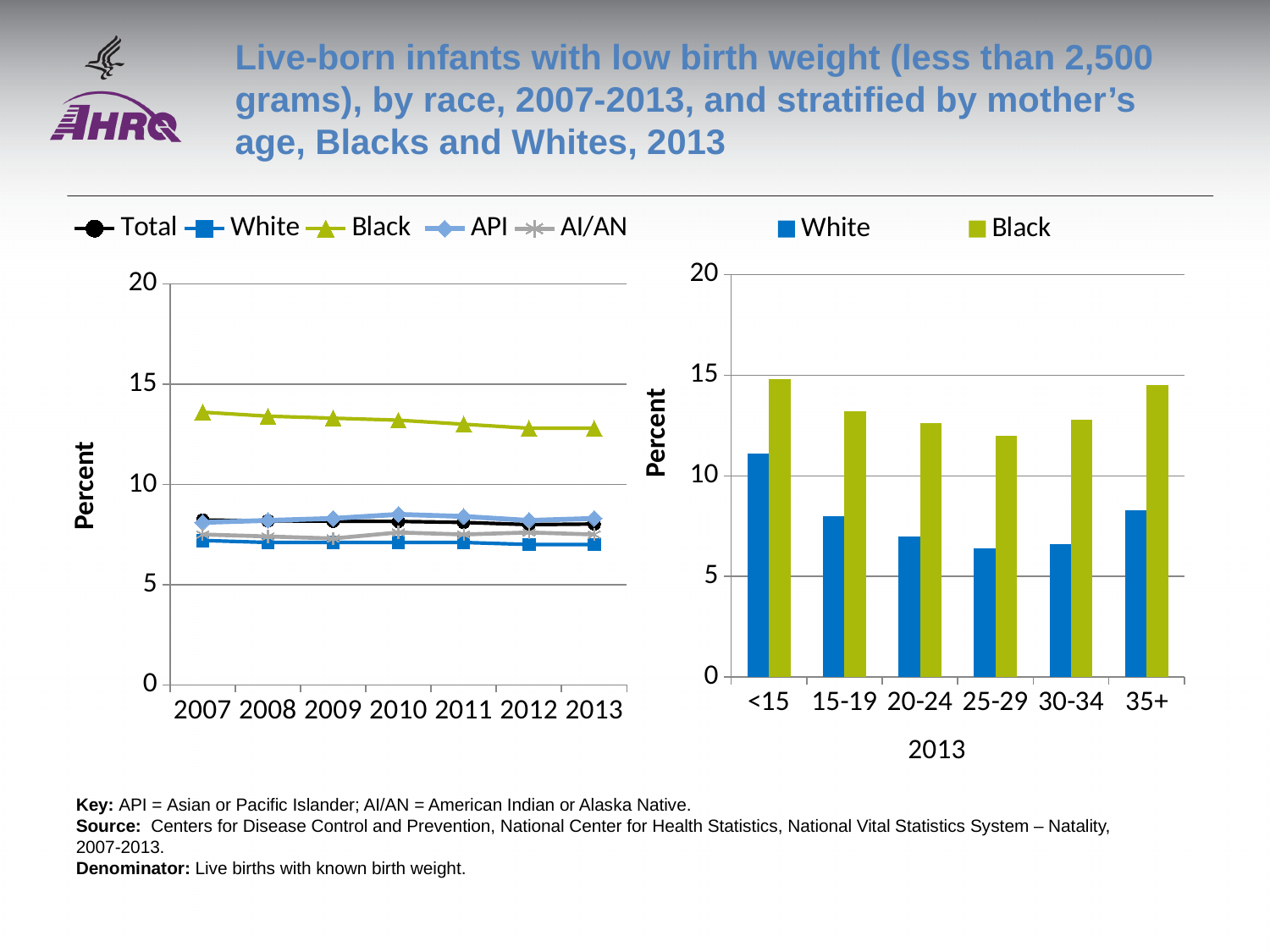
In the right chart (by mother's age, 2013), is the value for White in the <15 age group greater or less than 10? greater What kind of chart is the left chart showing low birth weight by race, 2007-2013? line chart In the right chart (by mother's age, 2013), how many series does the legend list? 2 In the left chart (by race, 2007-2013), is the value for Black in 2007 greater or less than 10? greater In the left chart (by race, 2007-2013), which race has the highest percentage of low birth weight infants across all years? Black In the right chart (by mother's age, 2013), how many age groups are shown on the x axis? 6 What kind of chart is the right chart showing low birth weight by mother's age, 2013? bar chart In the right chart (by mother's age, 2013), which age group has the highest percentage for White? <15 In the left chart (by race, 2007-2013), how many years are shown on the x axis? 7 In the left chart (by race, 2007-2013), does the Black series rise or fall from 2007 to 2013? fall In the right chart (by mother's age, 2013), which is larger for the 25-29 age group, White or Black? Black In the left chart (by race, 2007-2013), how many series does the legend list? 5